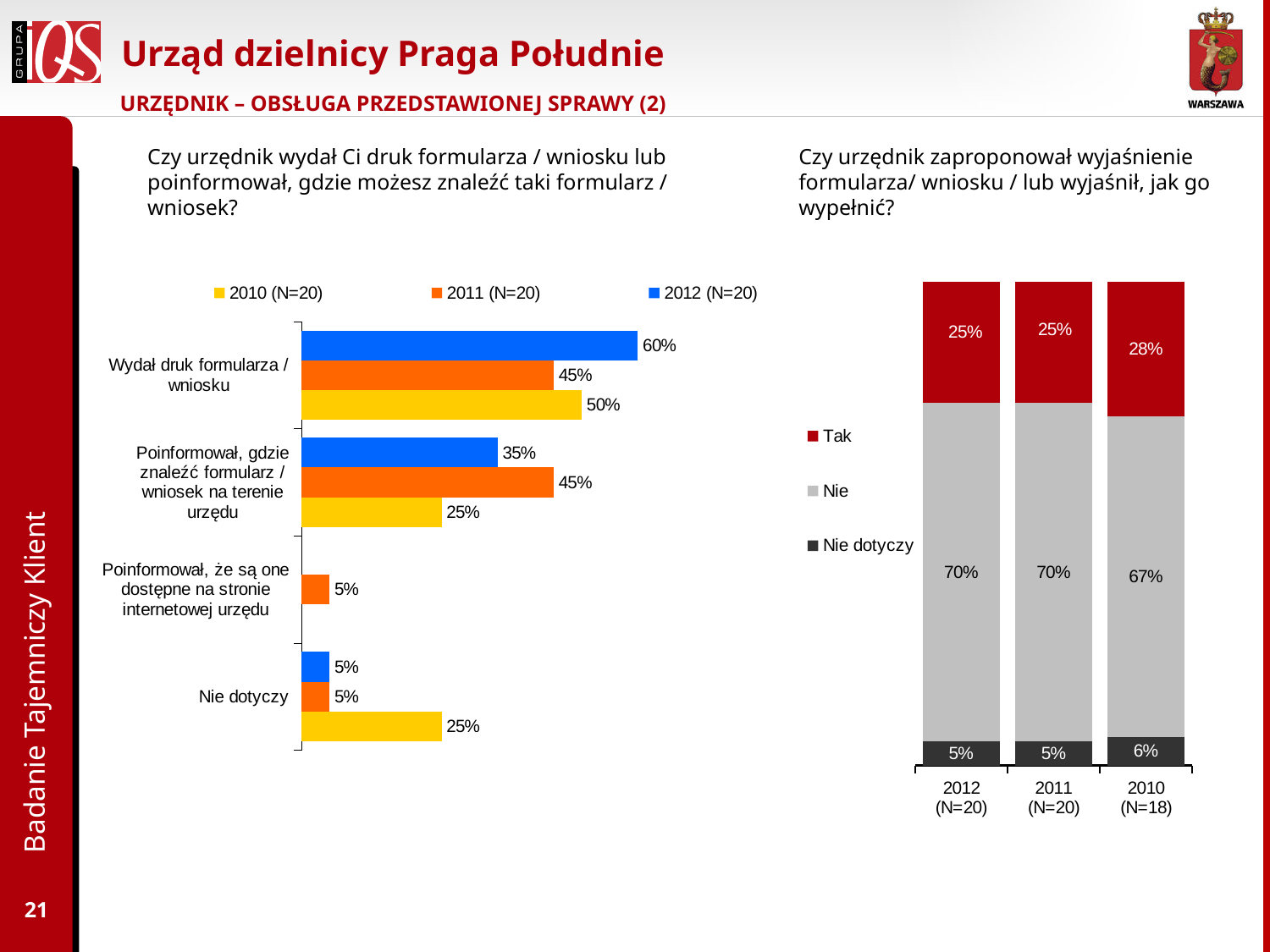
How many categories are shown on the left chart? 4 In the right chart, what is the 'Tak' value for 2012 (N=20)? 25% In the right chart, which year has the highest 'Tak' value? 2010 (N=18) In the left chart, what is the 2012 (N=20) value for 'Wydał druk formularza / wniosku'? 60% What kind of chart is the chart on the right of the slide? Stacked bar chart In the right chart, what is the 'Nie' value for 2010 (N=18)? 67% In the left chart, what is the 2011 (N=20) value for 'Poinformował, gdzie znaleźć formularz / wniosek na terenie urzędu'? 45% In the left chart, what is the difference between the 2012 and 2011 values for 'Wydał druk formularza / wniosku'? 15% In the left chart, what is the 2010 (N=20) value for 'Nie dotyczy'? 25% In the left chart, which category has the highest 2012 (N=20) value? Wydał druk formularza / wniosku In the left chart, which is larger for 'Poinformował, gdzie znaleźć formularz / wniosek na terenie urzędu': the 2011 value or the 2010 value? 2011 How many series does the legend of the left chart list? 3